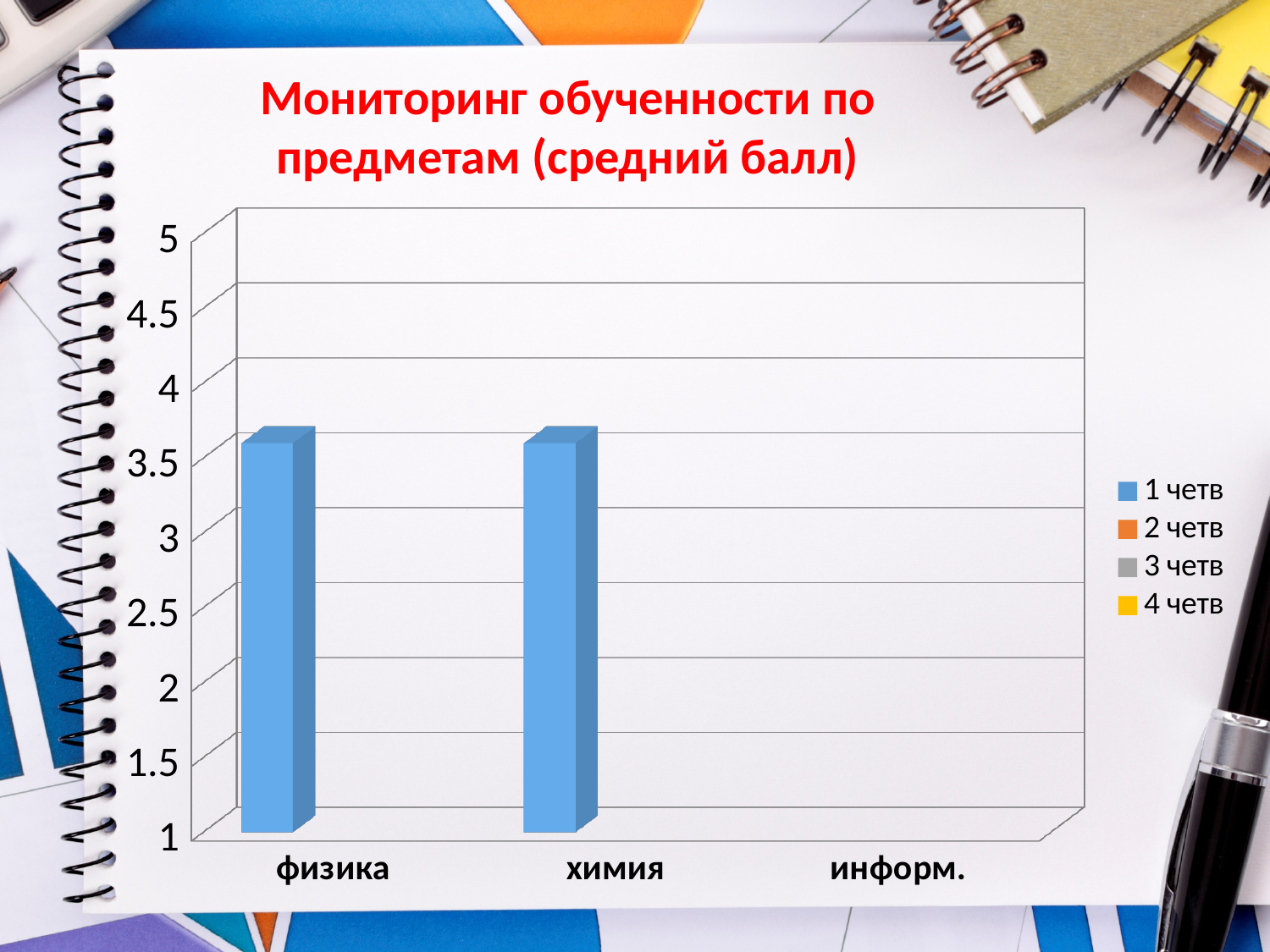
How many categories are shown on the x axis of the chart? 3 What kind of chart is shown on the slide? bar chart How many series does the chart legend list? 4 Is the value for физика greater or less than 4? less Is the value for химия greater or less than 4? less What is the lowest value shown on the vertical axis? 1 What is the title of the chart? Мониторинг обученности по предметам (средний балл) Is the value for физика greater or less than 3? greater Which category on the x axis has no bar plotted? информ. What is the highest value shown on the vertical axis? 5